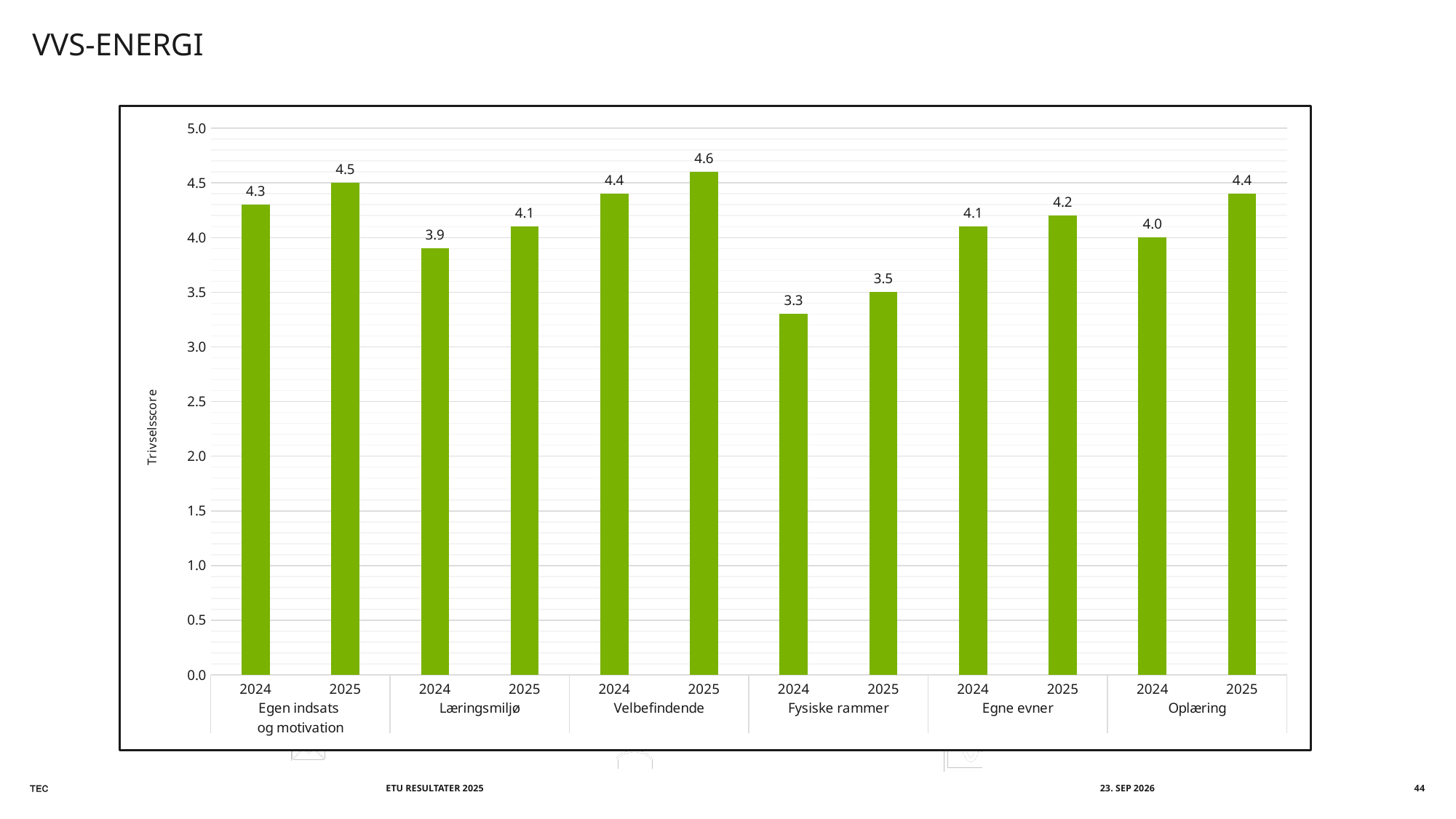
What kind of chart is shown on the slide? bar chart How many bars are plotted on the chart? 12 What is the label of the vertical axis? Trivselsscore What is the difference between the 2025 and 2024 Trivselsscore for Læringsmiljø? 0.2 What is the Trivselsscore for Egen indsats og motivation in 2025? 4.5 Which bar has the highest Trivselsscore on the chart? Velbefindende 2025 Is the 2025 Trivselsscore for Fysiske rammer greater or less than 4.0? less What is the Trivselsscore for Fysiske rammer in 2024? 3.3 What is the difference between the 2025 and 2024 Trivselsscore for Oplæring? 0.4 Which bar has the lowest Trivselsscore on the chart? Fysiske rammer 2024 Which is larger: the 2024 Trivselsscore for Velbefindende or the 2024 Trivselsscore for Egne evner? Velbefindende 2024 What is the Trivselsscore for Oplæring in 2025? 4.4